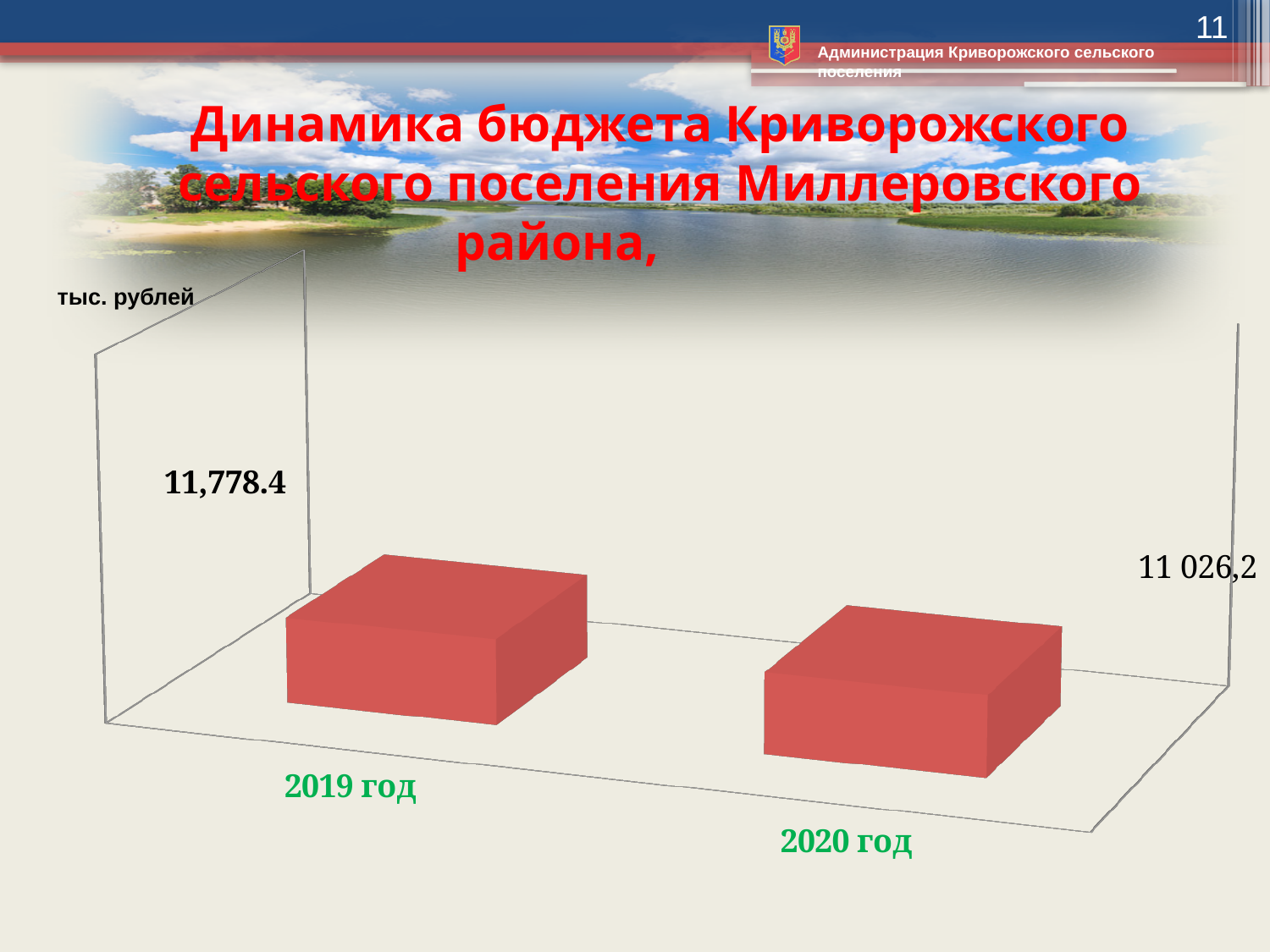
Which year has the lower budget value? 2020 год What is the budget value shown for 2020 год? 11 026,2 By how much does the budget value for 2019 год exceed the value for 2020 год? 752.2 In what units are the chart values expressed, according to the label on the slide? тыс. рублей How many years (categories) are plotted on the chart? 2 What is the budget value shown for 2019 год? 11,778.4 Is the value for 2019 год larger or smaller than the value for 2020 год? larger What kind of chart is shown on the slide? bar chart Which year has the higher budget value? 2019 год Does the budget value rise or fall from 2019 год to 2020 год? fall What colour are the bars on the chart? red